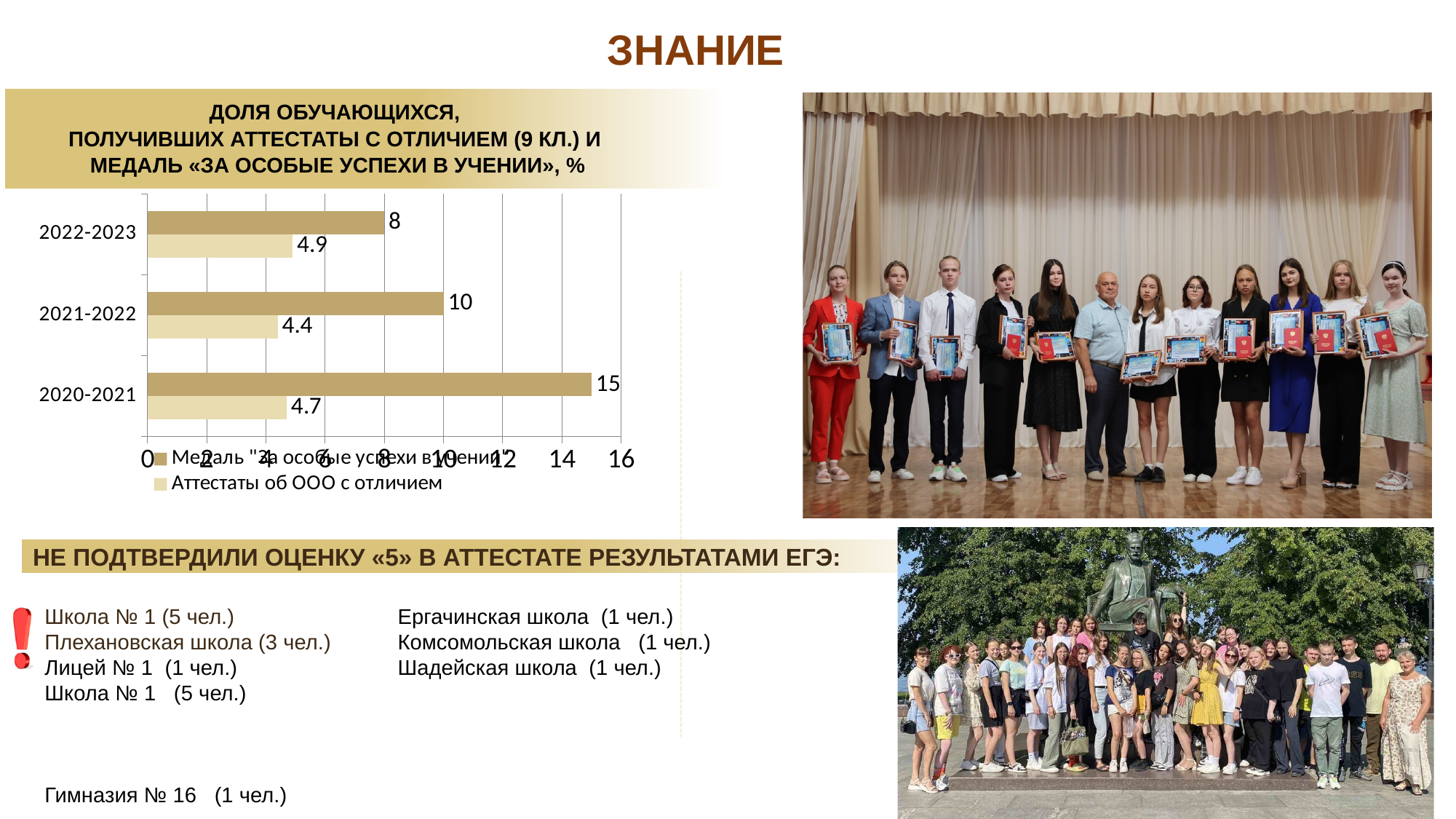
What is the value for "Аттестаты об ООО с отличием" in 2022-2023? 4.9 Which is larger in 2022-2023: the "Медаль" value or the "Аттестаты об ООО с отличием" value? Медаль "За особые успехи в учении" What type of chart is shown on the slide? Bar chart What is the value for "Аттестаты об ООО с отличием" in 2021-2022? 4.4 Does the "Медаль "За особые успехи в учении"" value rise or fall from 2020-2021 to 2022-2023? Fall How many school years are shown on the chart? 3 What is the difference between the "Медаль" value and the "Аттестаты об ООО с отличием" value in 2020-2021? 10.3 In which school year is the "Медаль "За особые успехи в учении"" value highest? 2020-2021 In which school year is the "Медаль "За особые успехи в учении"" value lowest? 2022-2023 How many series does the chart legend list? 2 What is the value for the "Медаль "За особые успехи в учении"" series in 2020-2021? 15 What is the value for the "Медаль "За особые успехи в учении"" series in 2021-2022? 10